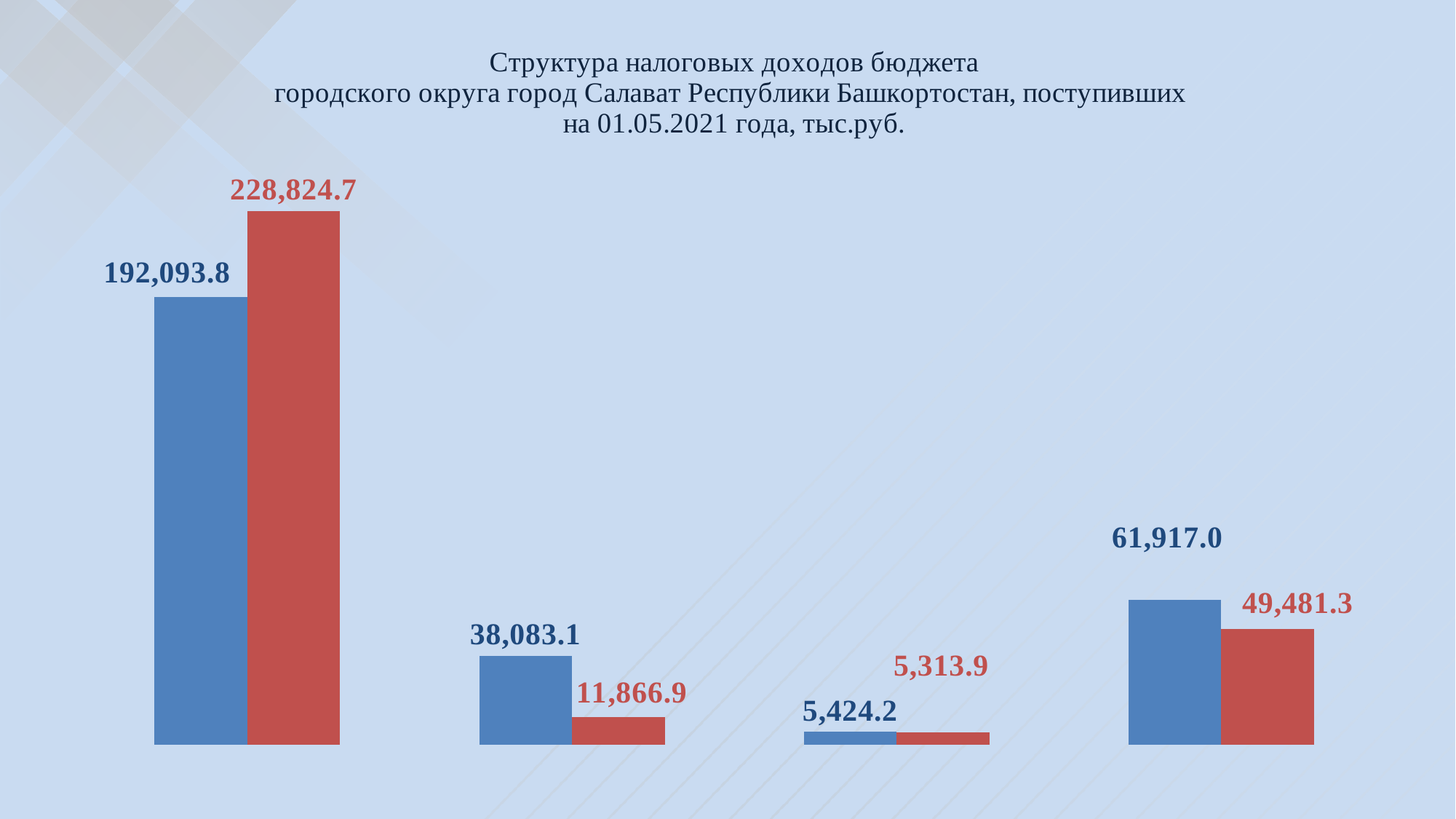
What is the value of the red bar in the third group from the left? 5,313.9 What is the value of the red bar in the fourth (rightmost) group? 49,481.3 What is the difference between the red and blue bars in the first (leftmost) group? 36,730.9 Which bar has the highest value on the chart? The red bar in the first group (228,824.7) Which bar has the lowest value on the chart? The red bar in the third group (5,313.9) What is the difference between the blue and red bars in the fourth (rightmost) group? 12,435.7 In the third group from the left, which bar is larger, the blue one or the red one? The blue one (5,424.2) What is the value of the red bar in the first (leftmost) group? 228,824.7 What is the value of the blue bar in the second group from the left? 38,083.1 What unit of measurement is stated in the chart title? тыс.руб. What is the value of the blue bar in the first (leftmost) group? 192,093.8 How many groups of bars are shown on the chart? 4